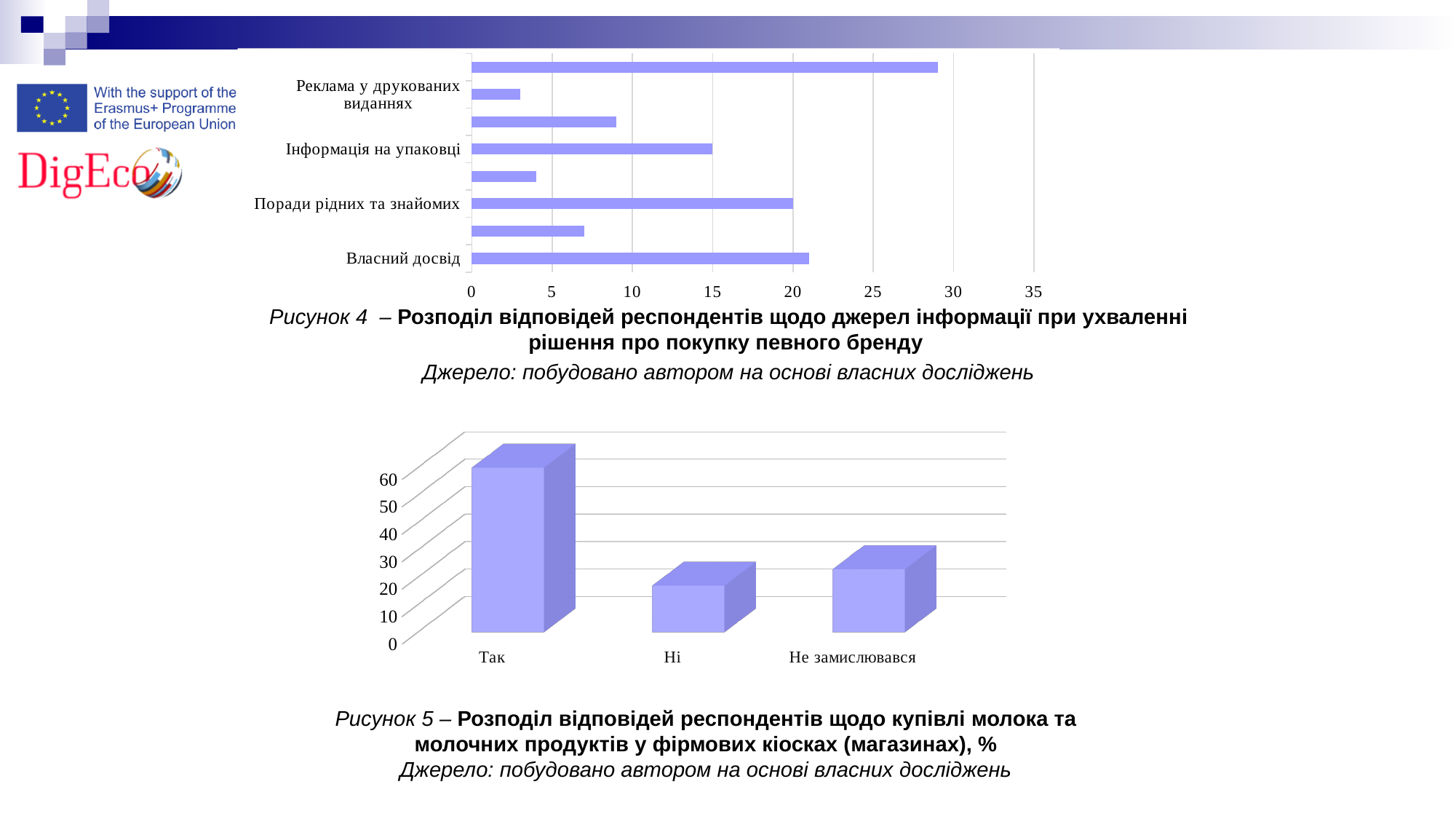
In the top chart (Рисунок 4), which is larger: Поради рідних та знайомих or Реклама у друкованих виданнях? Поради рідних та знайомих In the bottom chart (Рисунок 5), which category has the highest value? Так How many categories are shown in the bottom chart (Рисунок 5)? 3 What kind of chart is the top chart (Рисунок 4)? bar chart In the top chart (Рисунок 4), is the value for Реклама у друкованих виданнях greater or less than 5? less In the bottom chart (Рисунок 5), which category has the lowest value? Ні What kind of chart is the bottom chart (Рисунок 5)? bar chart In the top chart (Рисунок 4), is the value for Інформація на упаковці greater or less than 10? greater In the bottom chart (Рисунок 5), is the value for Так greater or less than 50? greater How many bars are plotted in the top chart (Рисунок 4)? 8